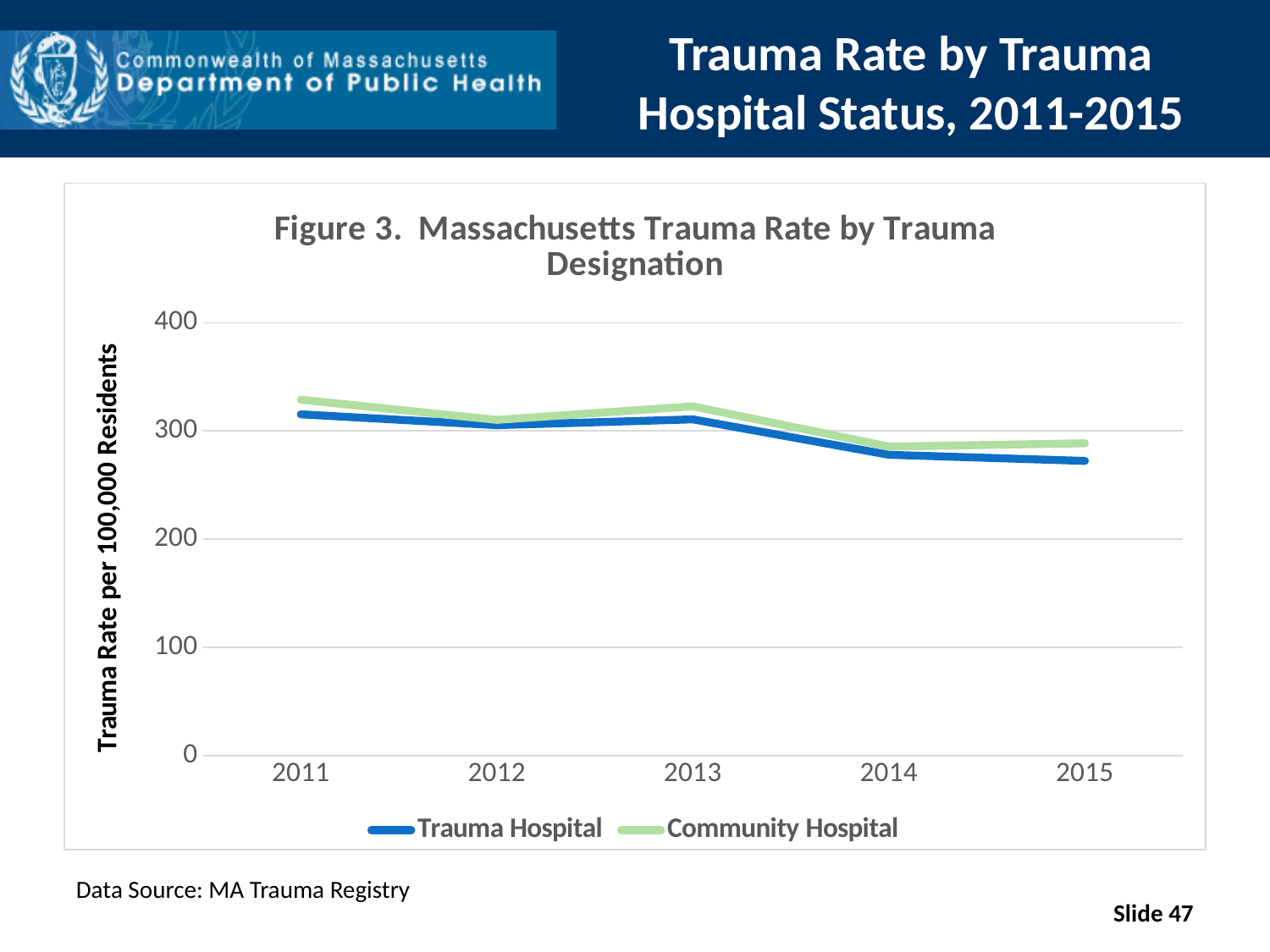
Which series has the higher trauma rate in 2011, Trauma Hospital or Community Hospital? Community Hospital How many series does the legend list? 2 Is the value for Community Hospital in 2013 greater or less than 300? greater Is the value for Trauma Hospital in 2011 greater or less than 300? greater Is the value for Trauma Hospital in 2014 greater or less than 300? less Is the Trauma Hospital rate larger in 2011 or in 2015? 2011 How many years are plotted along the x axis? 5 What is the label on the y axis of the chart? Trauma Rate per 100,000 Residents Overall, do the trauma rates rise or fall from 2011 to 2015? Fall What kind of chart is shown on the slide? Line chart